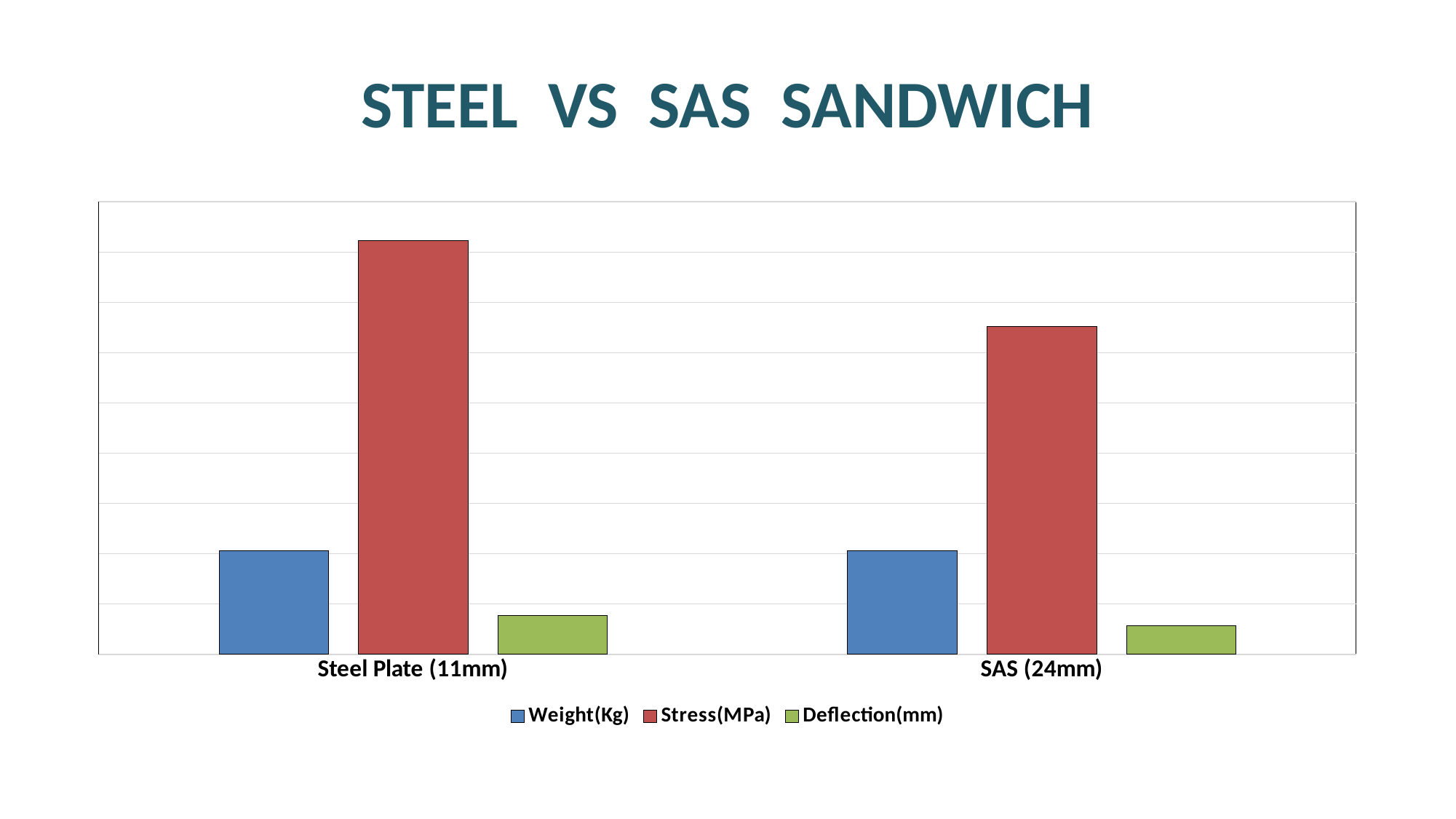
Which category has the tallest bar in the whole chart? Steel Plate (11mm) Which series has the tallest bar for SAS (24mm)? Stress(MPa) Which series has the tallest bar for Steel Plate (11mm)? Stress(MPa) Which series has the shortest bar for Steel Plate (11mm)? Deflection(mm) What is the title of the chart on the slide? STEEL VS SAS SANDWICH Which category has the larger Stress(MPa) value, Steel Plate (11mm) or SAS (24mm)? Steel Plate (11mm) Which series has the shortest bar for SAS (24mm)? Deflection(mm) What kind of chart is shown on the slide? Bar chart How many series does the chart's legend list? 3 Which series is shown in red in the chart? Stress(MPa) How many categories are shown on the x axis of the chart? 2